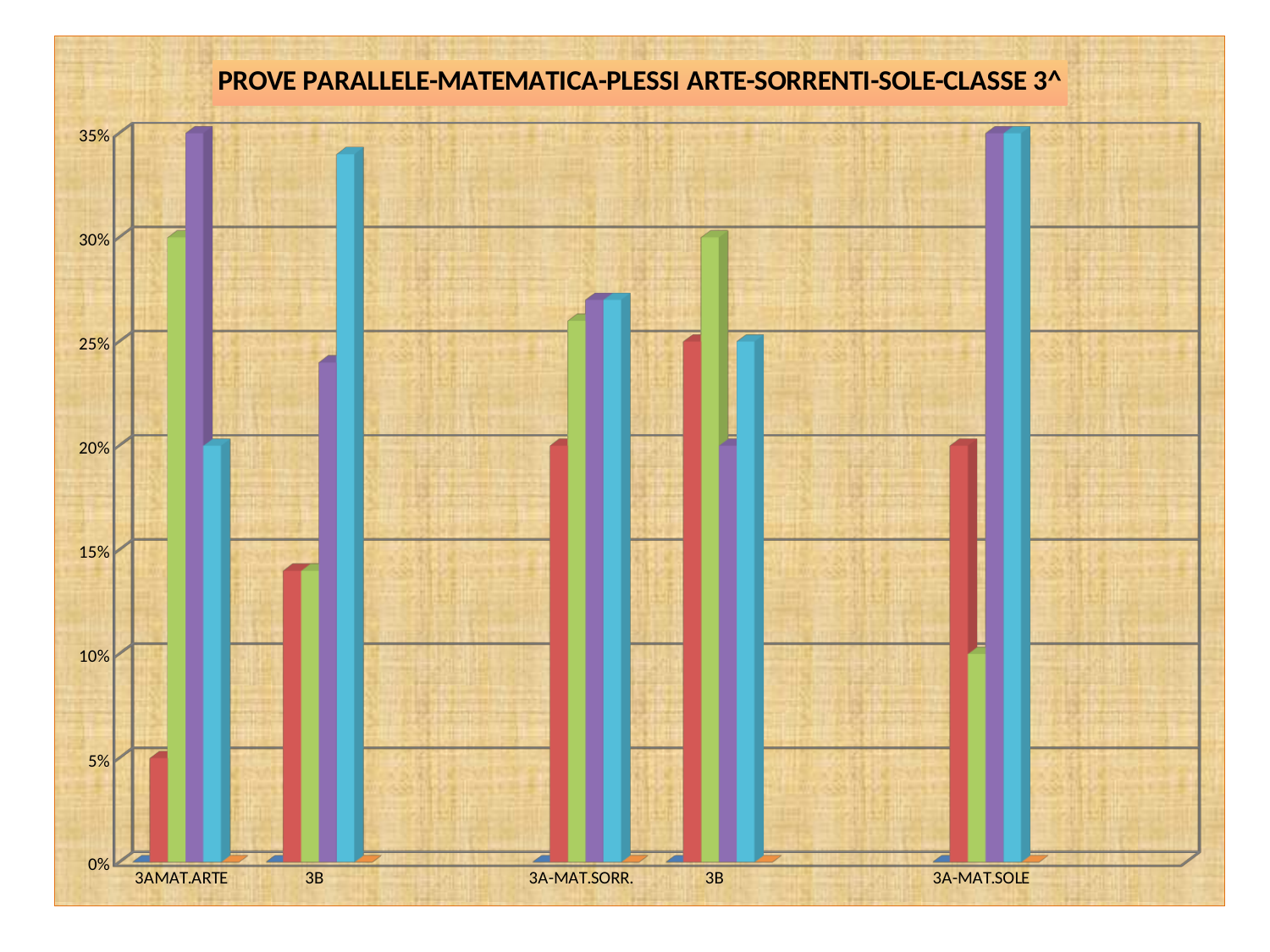
Is the value of the light blue bar for 3A-MAT.SOLE greater or less than 30%? greater For 3A-MAT.SOLE, which is larger: the purple bar or the green bar? the purple bar What is the title of the chart? PROVE PARALLELE-MATEMATICA-PLESSI ARTE-SORRENTI-SOLE-CLASSE 3^ Which coloured bar is the tallest for 3AMAT.ARTE? the purple bar How many categories are shown along the x axis of the chart? 5 For 3AMAT.ARTE, which is larger: the purple bar or the red bar? the purple bar Is the value of the light blue bar for the first 3B category greater or less than 30%? greater Is the value of the red bar for 3A-MAT.SORR. greater or less than 25%? less What kind of chart is shown on the slide? bar chart